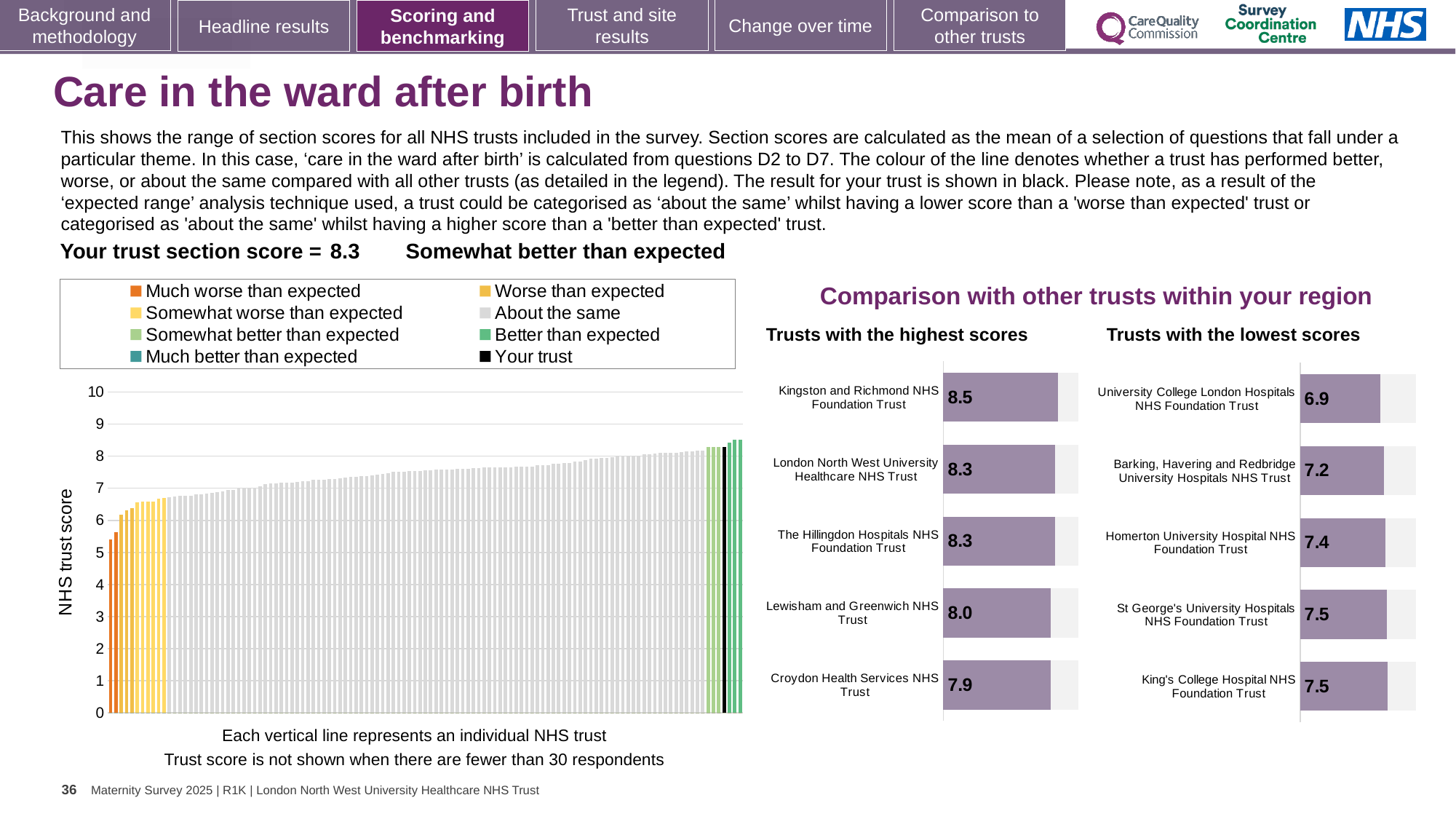
How many trusts are listed in the 'Trusts with the highest scores' chart? 5 In the 'Trusts with the lowest scores' chart, what is the score for University College London Hospitals NHS Foundation Trust? 6.9 In the 'Trusts with the lowest scores' chart, which trust has the lowest score? University College London Hospitals NHS Foundation Trust In the 'Trusts with the lowest scores' chart, how much higher is Homerton University Hospital NHS Foundation Trust's score than University College London Hospitals NHS Foundation Trust's? 0.5 What kind of chart is the main 'NHS trust score' chart on the left of the slide? Bar chart In the 'Trusts with the highest scores' chart, what is the difference between the scores of Kingston and Richmond NHS Foundation Trust and Croydon Health Services NHS Trust? 0.6 In the main 'NHS trust score' chart, is the value for the leftmost (lowest-scoring) trust greater or less than 6? less In the 'Trusts with the highest scores' chart, what is the score for Kingston and Richmond NHS Foundation Trust? 8.5 How many entries does the legend above the main 'NHS trust score' chart list? 8 In the main 'NHS trust score' chart, do the values rise or fall from left to right? Rise In the 'Trusts with the highest scores' chart, which trust has the highest score? Kingston and Richmond NHS Foundation Trust Which has the higher score: Lewisham and Greenwich NHS Trust in the highest-scores chart or Barking, Havering and Redbridge University Hospitals NHS Trust in the lowest-scores chart? Lewisham and Greenwich NHS Trust